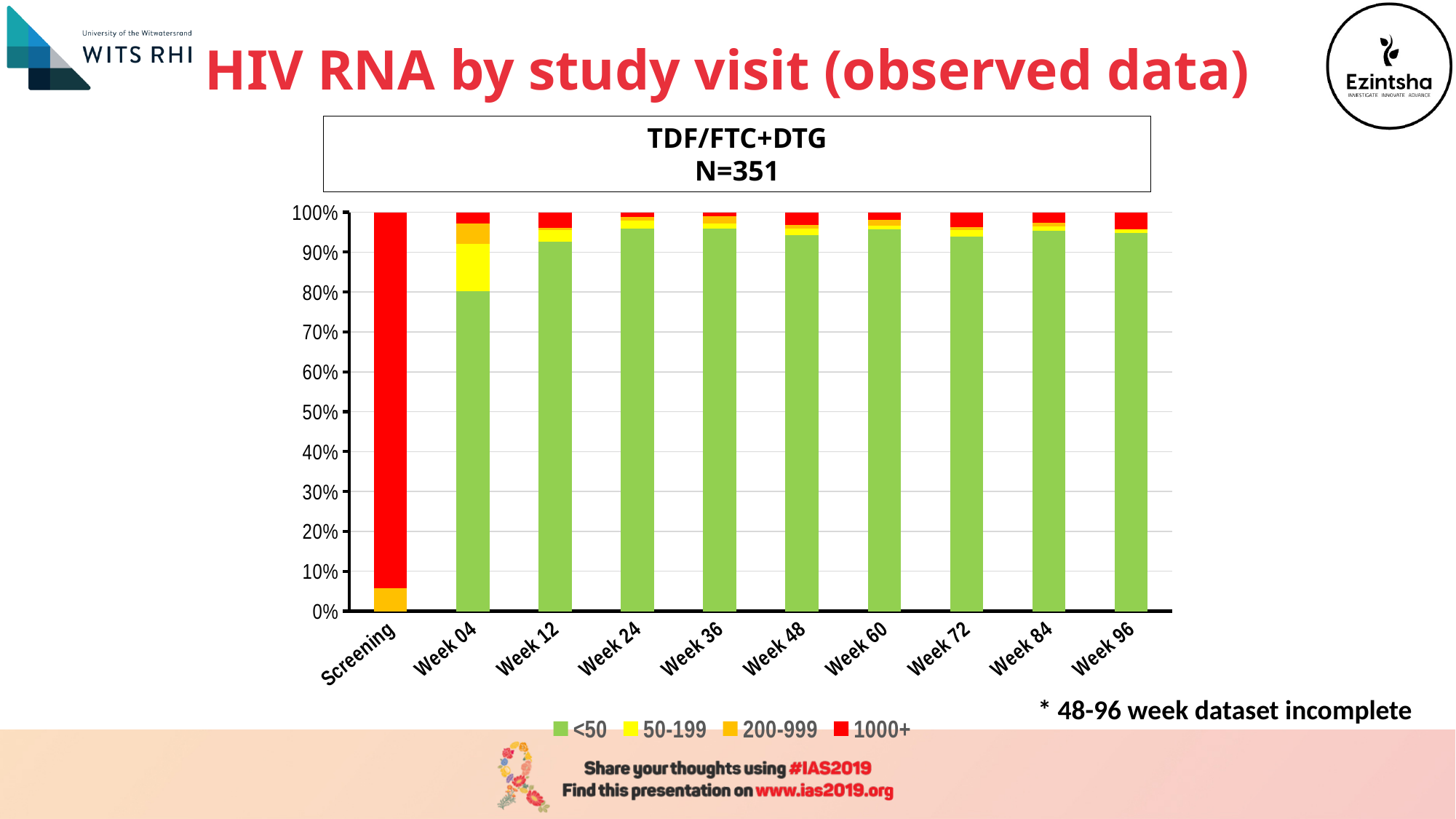
Which visit has the largest 1000+ share? Screening What kind of chart is shown on the slide? Stacked bar chart Which is larger, the <50 share at Week 04 or at Week 12? Week 12 Does the <50 share rise or fall from Week 04 to Week 24? rise How many series does the chart legend list? 4 Is the 200-999 share at Screening greater or less than 10%? less Is the <50 share at Week 04 greater or less than 90%? less What treatment regimen and sample size are shown in the box above the chart? TDF/FTC+DTG, N=351 How many study visits are shown on the x axis of the chart? 10 Is the 1000+ share at Screening greater or less than 90%? greater Among the Week visits, which has the smallest <50 share? Week 04